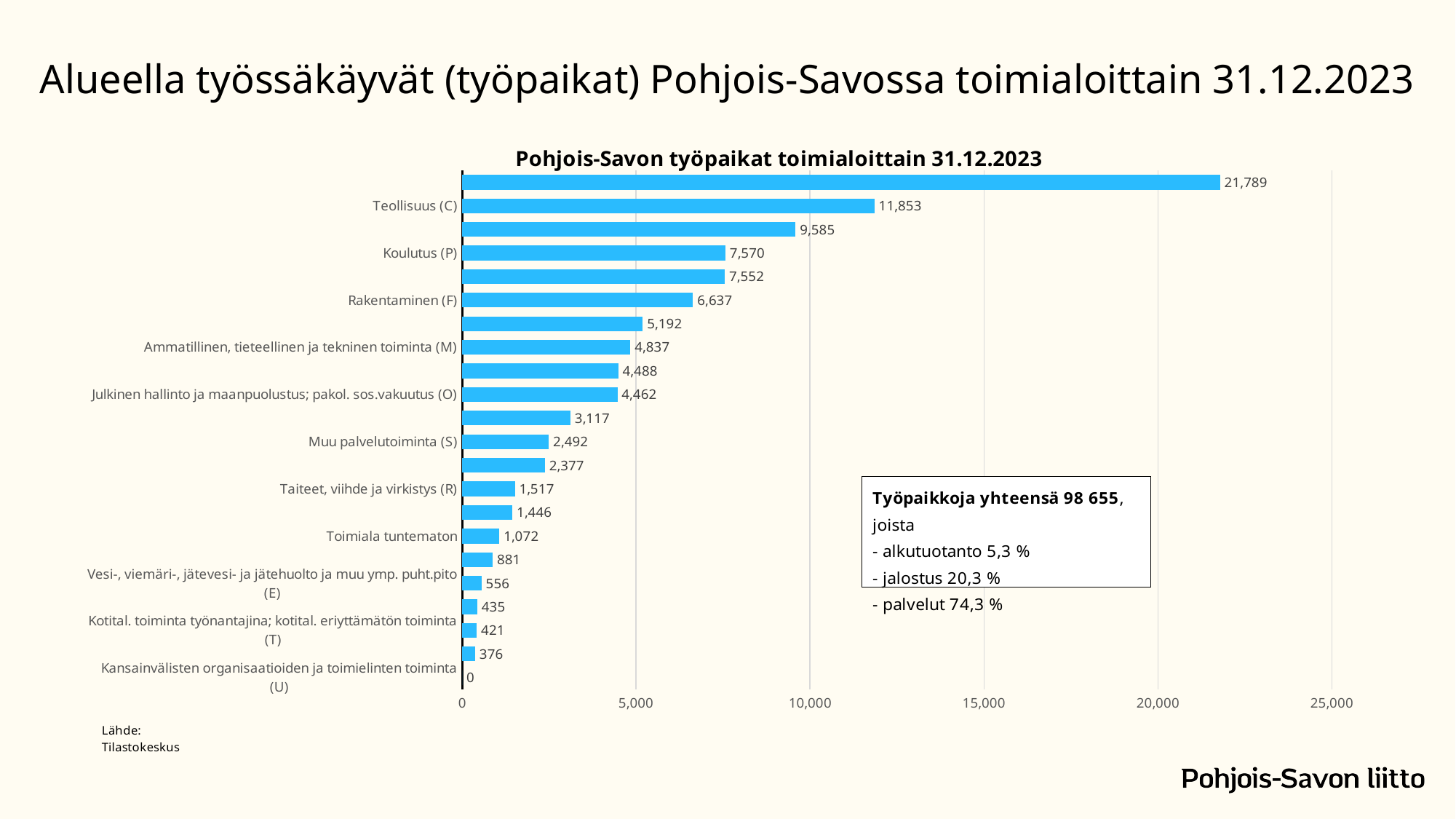
How many bars are plotted on the chart? 22 What is the value for Koulutus (P)? 7,570 What kind of chart is shown? Bar chart What is the title of the chart? Pohjois-Savon työpaikat toimialoittain 31.12.2023 What is the difference between the values for Koulutus (P) and Rakentaminen (F)? 933 What is the largest value shown on the chart? 21,789 What is the value for Toimiala tuntematon? 1,072 What is the value for Rakentaminen (F)? 6,637 What is the value for Teollisuus (C)? 11,853 Which labelled category has the lowest value? Kansainvälisten organisaatioiden ja toimielinten toiminta (U) Which is larger, the value for Muu palvelutoiminta (S) or Taiteet, viihde ja virkistys (R)? Muu palvelutoiminta (S) What is the value for Julkinen hallinto ja maanpuolustus; pakol. sos.vakuutus (O)? 4,462